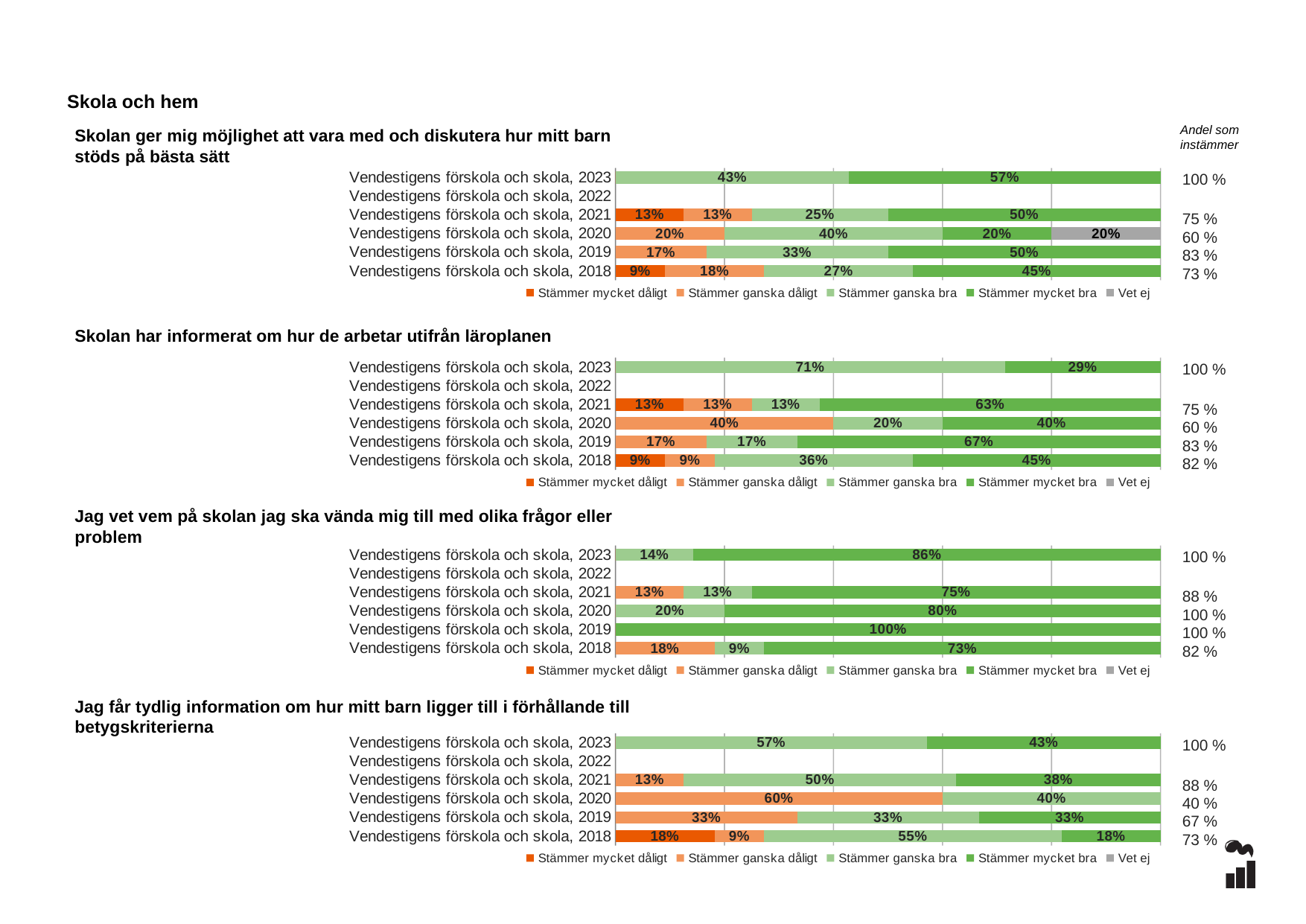
How many series does the legend list for the chart 'Skolan ger mig möjlighet att vara med och diskutera hur mitt barn stöds på bästa sätt'? 5 In the chart 'Jag vet vem på skolan jag ska vända mig till med olika frågor eller problem', what is the difference between the 'Stämmer mycket bra' values for 2023 and 2018? 13% In the chart 'Skolan har informerat om hur de arbetar utifrån läroplanen', which is larger: the 'Stämmer mycket bra' value for 2019 or for 2018? 2019 In the chart 'Skolan har informerat om hur de arbetar utifrån läroplanen', what is the 'Stämmer mycket bra' value for Vendestigens förskola och skola, 2021? 63% In the chart 'Jag får tydlig information om hur mitt barn ligger till i förhållande till betygskriterierna', what is the 'Stämmer ganska dåligt' value for Vendestigens förskola och skola, 2020? 60% What kind of chart is 'Jag vet vem på skolan jag ska vända mig till med olika frågor eller problem'? Stacked bar chart In the chart 'Skolan har informerat om hur de arbetar utifrån läroplanen', what is the 'Stämmer ganska bra' value for Vendestigens förskola och skola, 2023? 71% In the chart 'Skolan ger mig möjlighet att vara med och diskutera hur mitt barn stöds på bästa sätt', what is the 'Vet ej' value for Vendestigens förskola och skola, 2020? 20% In the chart 'Jag vet vem på skolan jag ska vända mig till med olika frågor eller problem', what is the 'Stämmer mycket bra' value for Vendestigens förskola och skola, 2019? 100% In the chart 'Skolan ger mig möjlighet att vara med och diskutera hur mitt barn stöds på bästa sätt', what is the 'Stämmer mycket bra' value for Vendestigens förskola och skola, 2023? 57% In the chart 'Skolan ger mig möjlighet att vara med och diskutera hur mitt barn stöds på bästa sätt', what is the 'Andel som instämmer' for Vendestigens förskola och skola, 2019? 83 % In the chart 'Jag får tydlig information om hur mitt barn ligger till i förhållande till betygskriterierna', which year has the lowest 'Andel som instämmer'? 2020